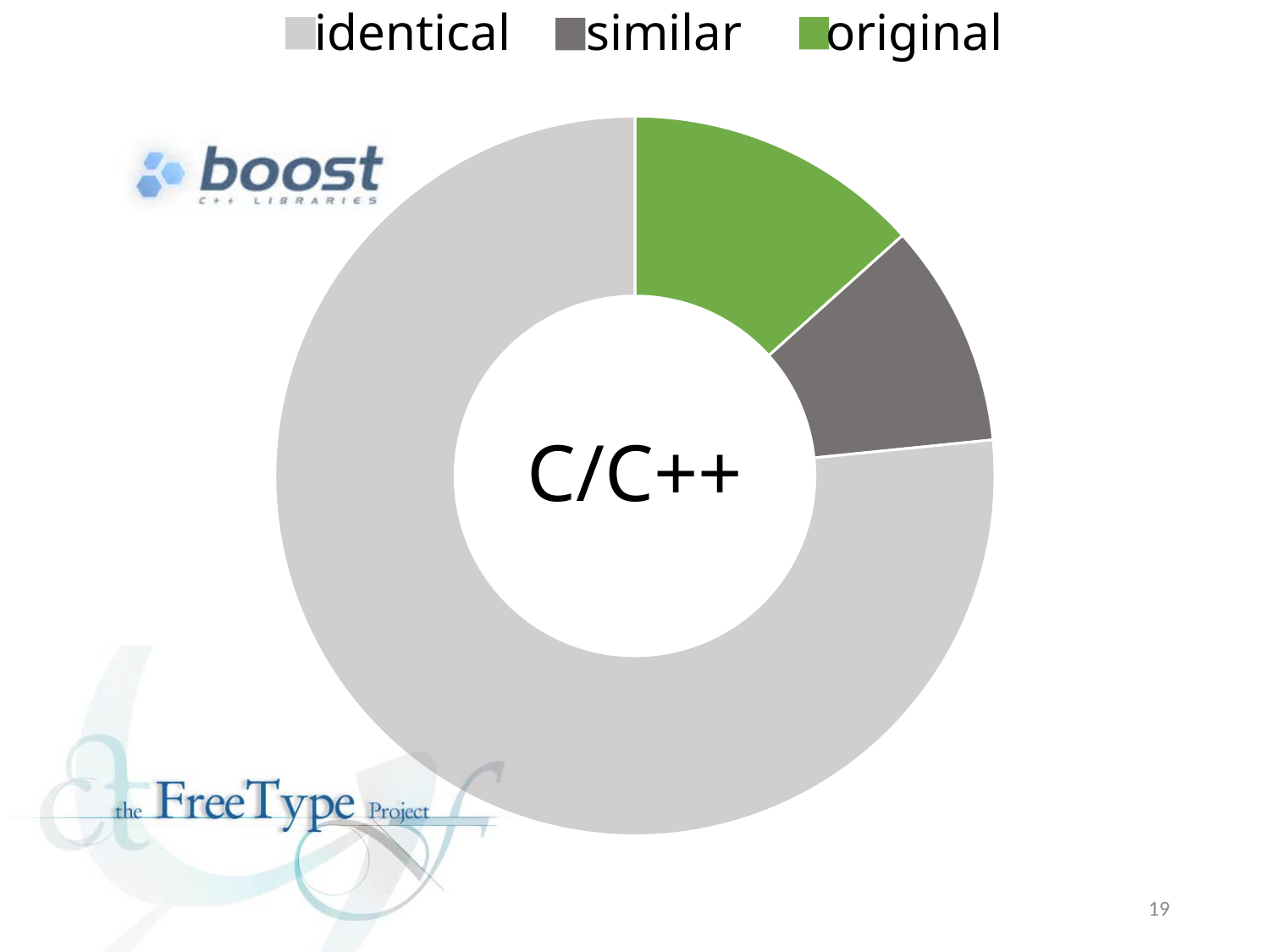
Which is larger, the share for similar or the share for original? original Which is larger, the share for identical or the share for similar? identical What kind of chart is shown on the slide? doughnut (pie) chart Which is larger, the share for identical or the share for original? identical What text is shown in the centre of the doughnut chart? C/C++ Which category has the smallest share of the chart? similar How many categories does the chart show? 3 Which category has the largest share of the chart? identical How many entries does the legend list? 3 Which colour represents the original category in the legend? green